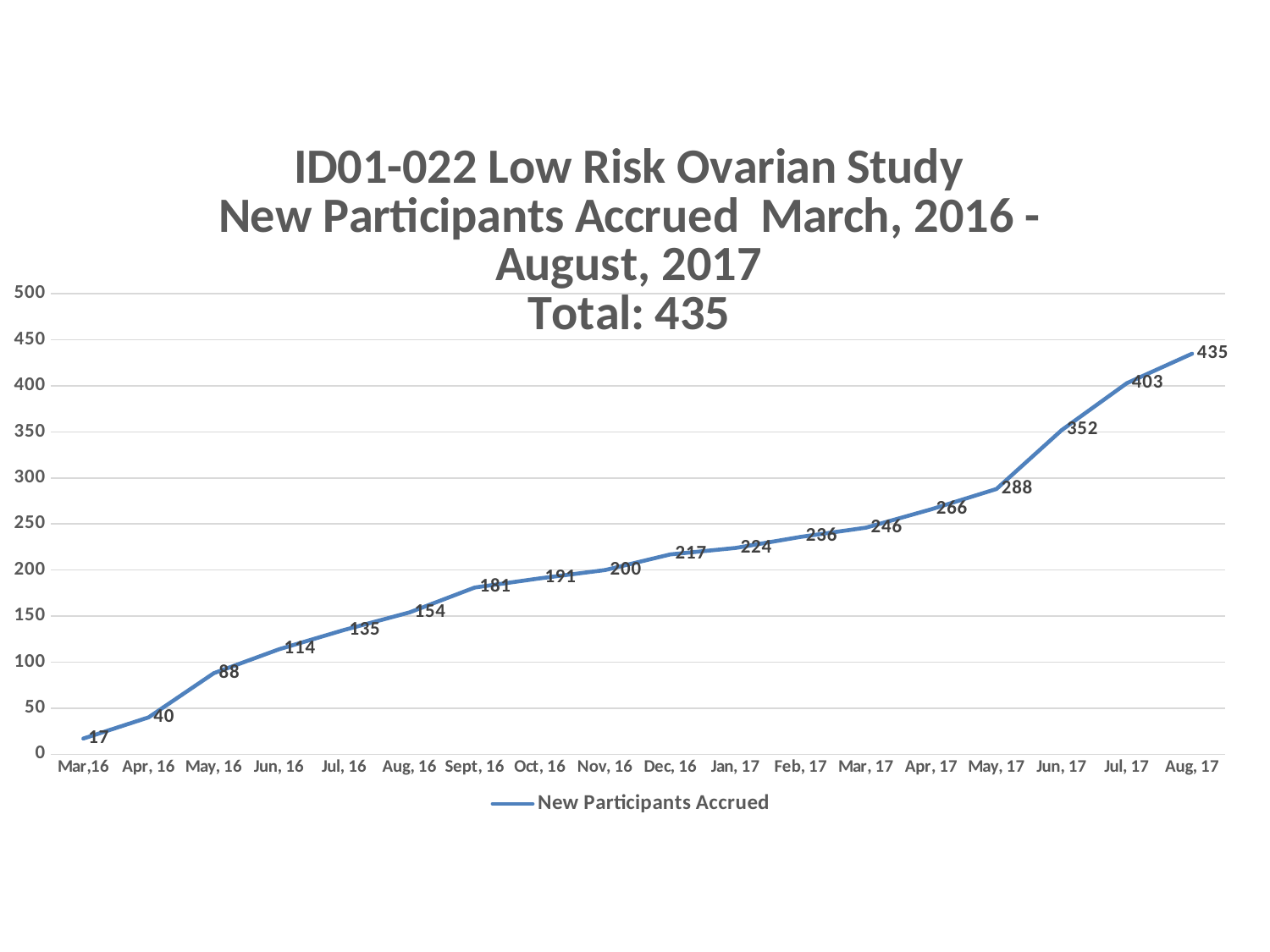
Which month has the highest value? Aug, 17 What is the value for Jun, 17? 352 What is the value for Sept, 16? 181 Which month has the lowest value? Mar,16 What kind of chart is this? line chart How many series does the legend list? 1 Do the values rise or fall from Mar,16 to Aug, 17? rise How many months are plotted on the x axis? 18 Which is larger, the value for Dec, 16 or the value for Feb, 17? Feb, 17 What is the difference between the values for May, 17 and Apr, 17? 22 What is the value for Mar, 17? 246 What is the difference between the values for Aug, 17 and Jul, 17? 32